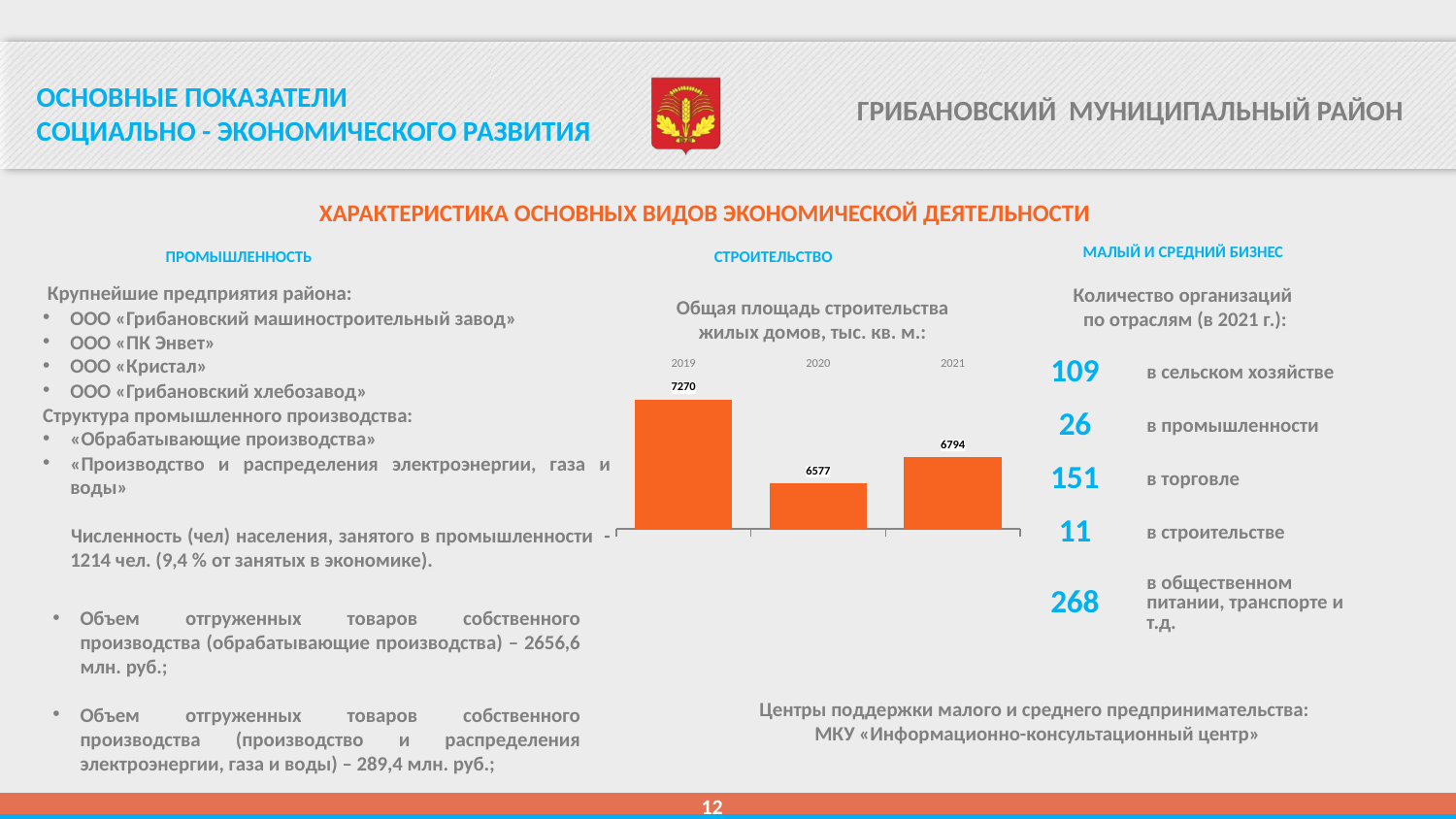
What is the title of the bar chart on the slide? Общая площадь строительства жилых домов, тыс. кв. м. What is the value for 2020 in the chart 'Общая площадь строительства жилых домов, тыс. кв. м.'? 6577 What is the value for 2019 in the chart 'Общая площадь строительства жилых домов, тыс. кв. м.'? 7270 What is the difference between the 2021 and 2020 values in the chart 'Общая площадь строительства жилых домов, тыс. кв. м.'? 217 In the chart 'Общая площадь строительства жилых домов, тыс. кв. м.', which is larger: the value for 2019 or the value for 2021? 2019 What is the value for 2021 in the chart 'Общая площадь строительства жилых домов, тыс. кв. м.'? 6794 How many years (categories) are shown in the chart 'Общая площадь строительства жилых домов, тыс. кв. м.'? 3 What is the difference between the 2019 and 2020 values in the chart 'Общая площадь строительства жилых домов, тыс. кв. м.'? 693 Which year has the lowest value in the chart 'Общая площадь строительства жилых домов, тыс. кв. м.'? 2020 In the chart 'Общая площадь строительства жилых домов, тыс. кв. м.', does the value rise or fall from 2019 to 2020? fall What kind of chart is 'Общая площадь строительства жилых домов, тыс. кв. м.'? bar chart Which year has the highest value in the chart 'Общая площадь строительства жилых домов, тыс. кв. м.'? 2019